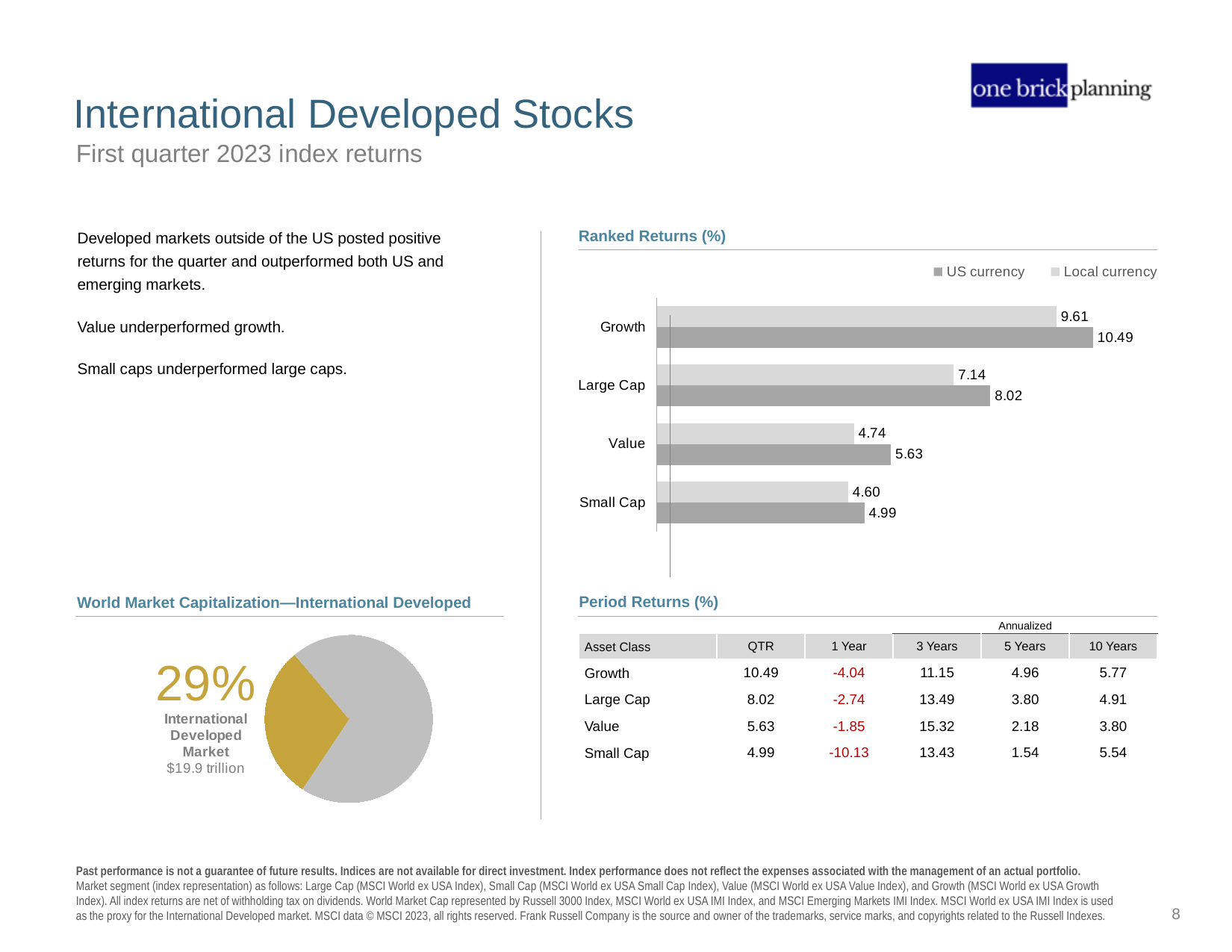
In the World Market Capitalization—International Developed pie chart, what share does the International Developed Market represent? 29% In the Ranked Returns (%) chart, which category has the lowest Local currency return? Small Cap In the Ranked Returns (%) chart, which category has the highest US currency return? Growth In the Ranked Returns (%) chart, what is the Local currency return for Small Cap? 4.60 How many categories are shown in the Ranked Returns (%) chart? 4 In the Ranked Returns (%) chart, what is the difference between the US currency and Local currency returns for Value? 0.89 In the Ranked Returns (%) chart, what is the US currency return for Growth? 10.49 In the Ranked Returns (%) chart, which is larger: the US currency return for Large Cap or the US currency return for Value? Large Cap What kind of chart is the Ranked Returns (%) chart? Bar chart In the Ranked Returns (%) chart, what is the Local currency return for Large Cap? 7.14 In the World Market Capitalization—International Developed pie chart, what dollar value is shown for the International Developed Market? $19.9 trillion How many series does the legend of the Ranked Returns (%) chart list? 2